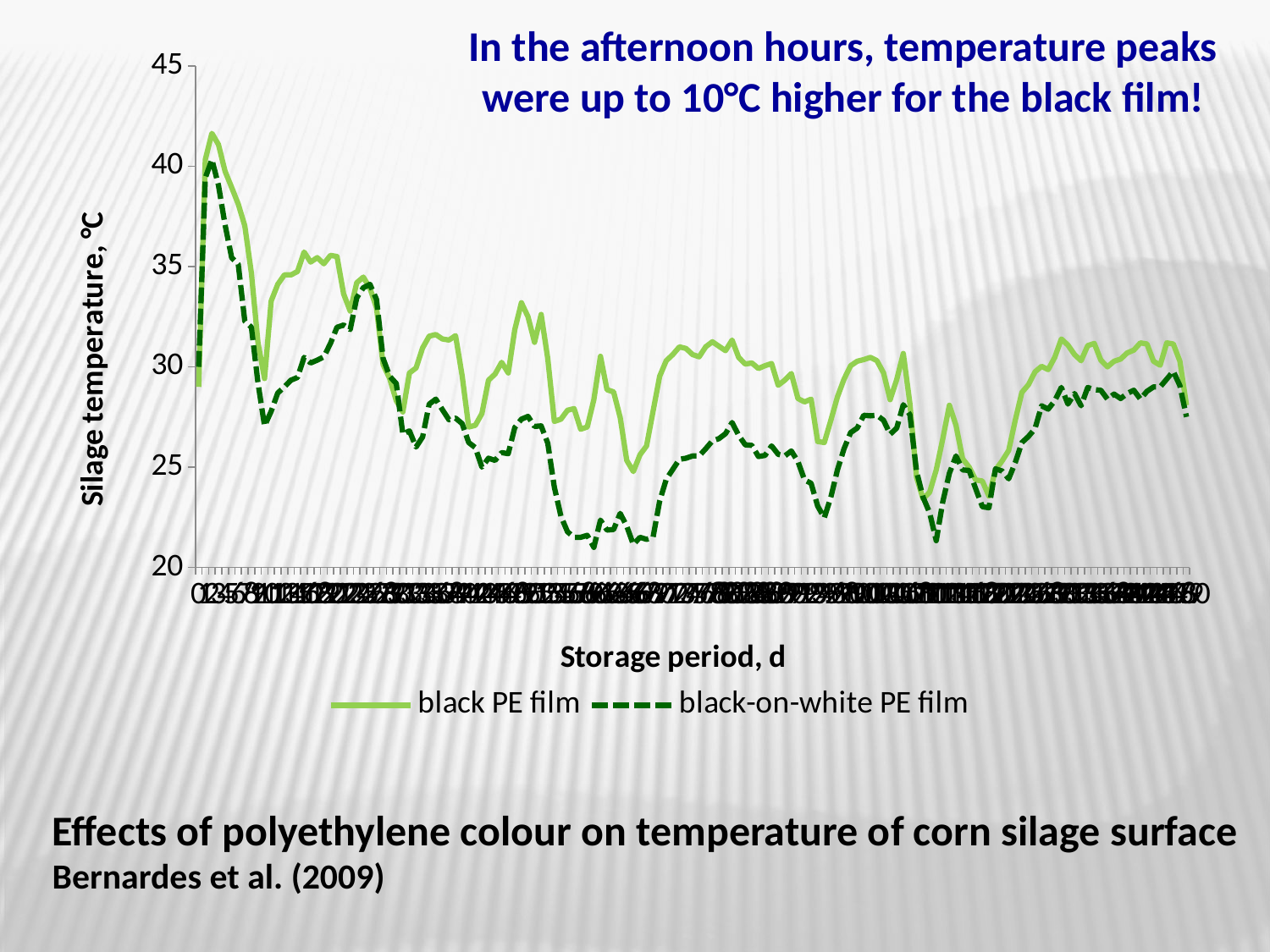
Is the lowest value for black-on-white PE film greater or less than 25? less Is the highest value for black PE film greater or less than 40? greater Is the lowest value for black PE film greater or less than 30? less How many series does the legend list? 2 What is the title of the y axis? Silage temperature, °C What kind of chart is shown on the slide? line chart Which series reaches the higher peak temperature, black PE film or black-on-white PE film? black PE film Which series is generally lower across the storage period, black PE film or black-on-white PE film? black-on-white PE film What is the title of the x axis? Storage period, d